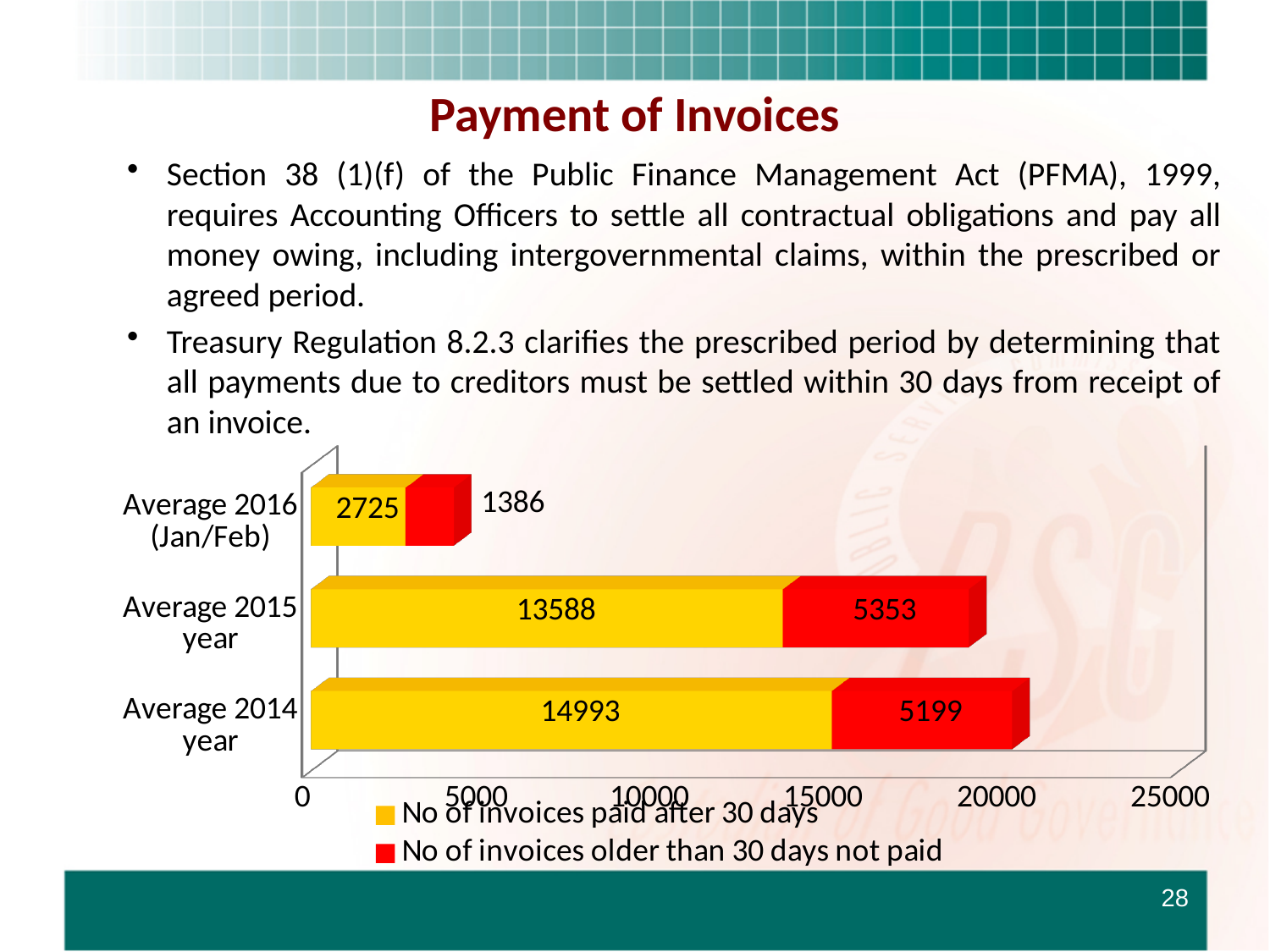
Which is larger: the number of invoices older than 30 days not paid in Average 2015 year or in Average 2014 year? Average 2015 year How many categories are shown on the chart? 3 What is the number of invoices paid after 30 days for Average 2014 year? 14993 Which colour represents the series 'No of invoices older than 30 days not paid'? Red Which category has the highest number of invoices paid after 30 days? Average 2014 year How many series does the chart legend list? 2 What kind of chart is shown on the slide? Stacked bar chart What is the number of invoices older than 30 days not paid for Average 2015 year? 5353 What is the total of the stacked bar for Average 2014 year? 20192 Which category has the lowest number of invoices older than 30 days not paid? Average 2016 (Jan/Feb) What is the difference between the number of invoices paid after 30 days in Average 2014 year and Average 2015 year? 1405 What is the number of invoices paid after 30 days for Average 2016 (Jan/Feb)? 2725